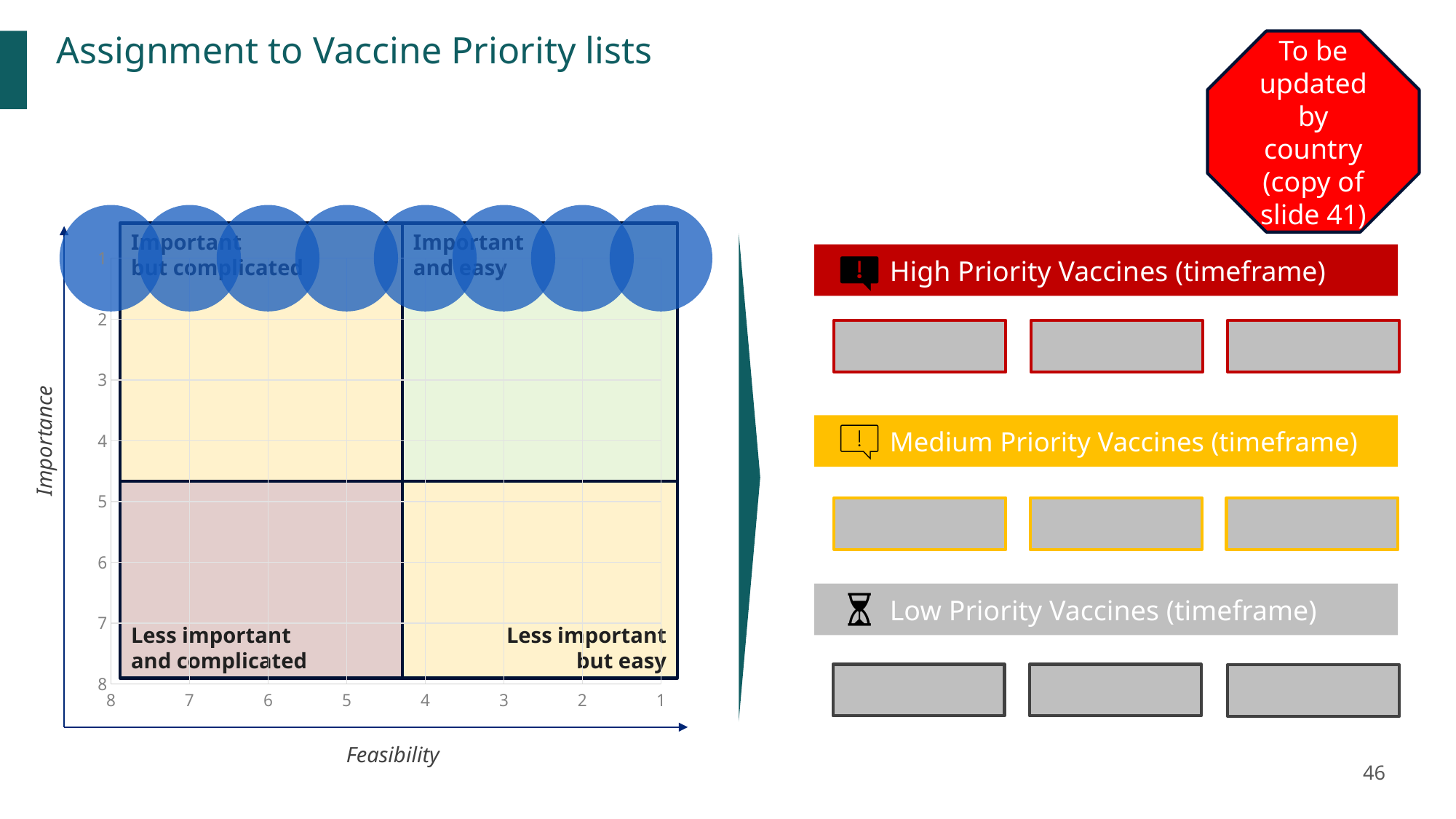
At which Feasibility tick value is the leftmost blue circle plotted? 8 What is the highest tick value shown on the Importance axis? 8 At which Feasibility tick value is the rightmost blue circle plotted? 1 What is the label of the horizontal axis of the chart? Feasibility At which Importance tick value are all the blue circles plotted? 1 What is the label of the vertical axis of the chart? Importance What kind of chart is shown on the left of the slide? bubble chart Is the Importance value of the blue circles greater or less than 4? less How many blue circles are plotted on the chart? 8 What is the lowest tick value shown on the Feasibility axis? 1